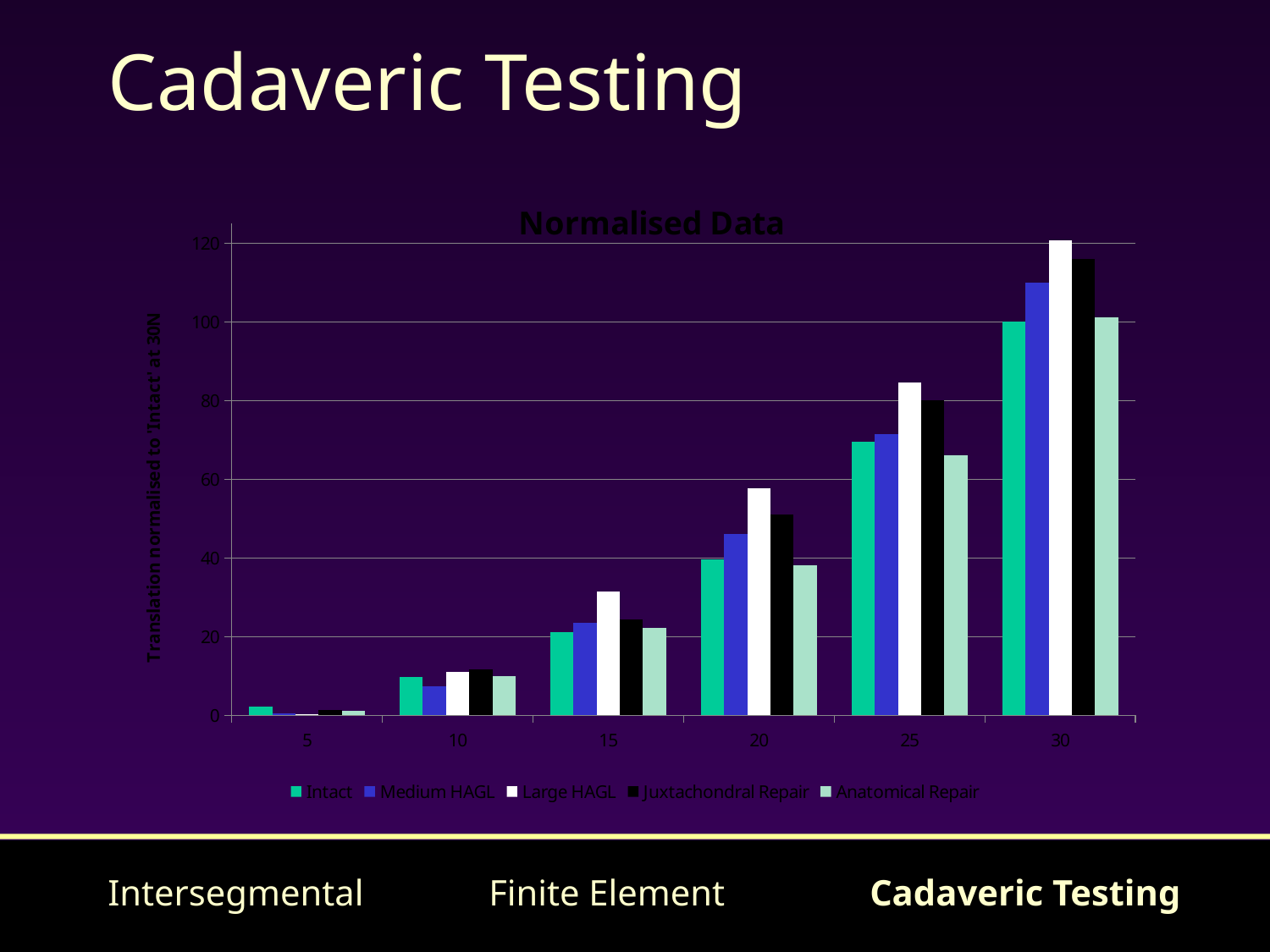
Is the value for Intact at x = 25 greater or less than 60? greater What is the value of the Intact series at x = 30 in the 'Normalised Data' chart? 100 How many series does the legend of the 'Normalised Data' chart list? 5 Which series has the highest bar at x = 30 in the 'Normalised Data' chart? Large HAGL Is the value for Large HAGL at x = 25 greater or less than 80? greater At x = 25, which is larger: Large HAGL or Intact? Large HAGL What kind of chart is shown under the title 'Normalised Data'? bar chart How many categories are shown on the x axis of the 'Normalised Data' chart? 6 Is the value for Medium HAGL at x = 20 greater or less than 40? greater What is the y-axis label of the 'Normalised Data' chart? Translation normalised to 'Intact' at 30N Do the values of the Intact series rise or fall as x increases from 5 to 30? rise